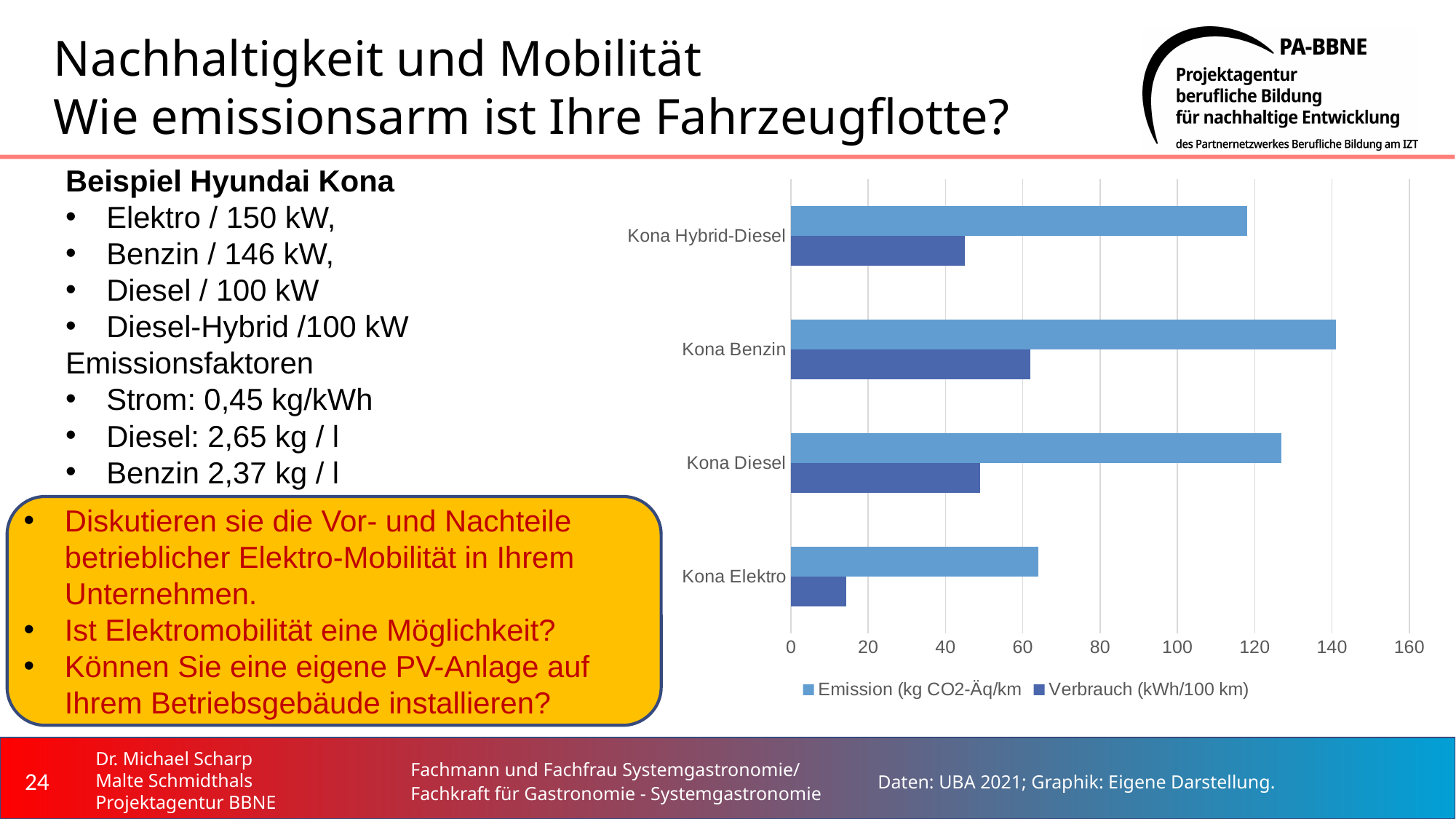
Is the Emission value for Kona Hybrid-Diesel greater or less than 100? greater How many vehicle categories are shown on the chart? 4 What kind of chart is shown on the slide? Bar chart Which vehicle has the lowest Emission (kg CO2-Äq/km) value? Kona Elektro Which vehicle has the highest Verbrauch (kWh/100 km) value? Kona Benzin Is the Verbrauch value for Kona Elektro greater or less than 20? less What are the two series named in the chart legend? Emission (kg CO2-Äq/km) and Verbrauch (kWh/100 km) Which vehicle has the highest Emission (kg CO2-Äq/km) value? Kona Benzin How many series does the chart legend list? 2 Is the Emission value for Kona Elektro greater or less than 80? less Which vehicle has the lowest Verbrauch (kWh/100 km) value? Kona Elektro Which has the larger Emission value, Kona Diesel or Kona Hybrid-Diesel? Kona Diesel